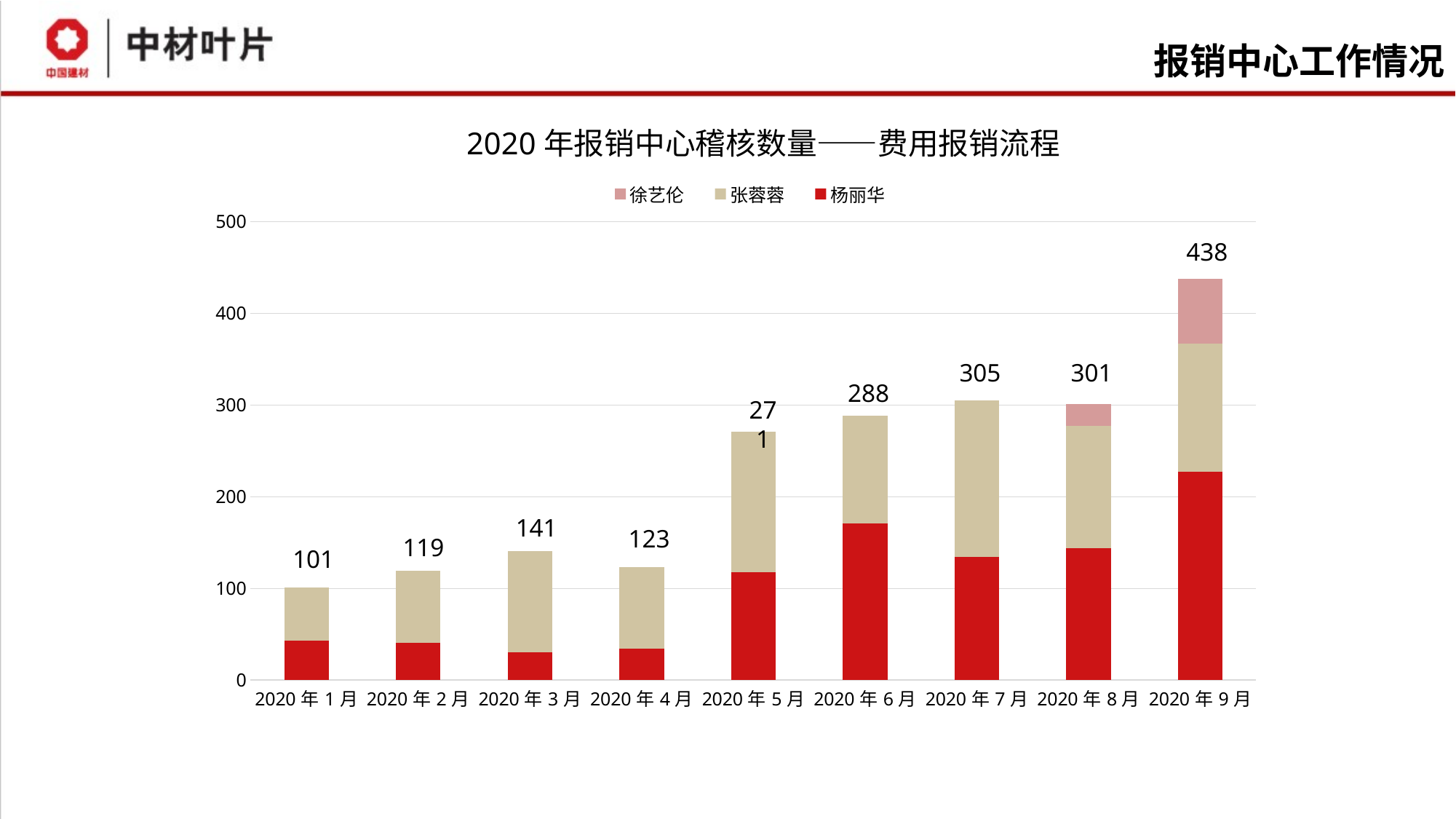
What is the total value labelled for 2020年9月? 438 How many months are shown on the x axis? 9 What is the total value labelled for 2020年1月? 101 Which is larger, the total for 2020年7月 or 2020年8月? 2020年7月 Which month has the lowest total? 2020年1月 What is the difference between the totals for 2020年9月 and 2020年8月? 137 What is the difference between the totals for 2020年3月 and 2020年4月? 18 What kind of chart is shown on the slide? bar chart Is the value for 杨丽华 in 2020年9月 greater or less than 200? greater Which month has the highest total? 2020年9月 How many series does the legend list? 3 Which series is shown in red? 杨丽华